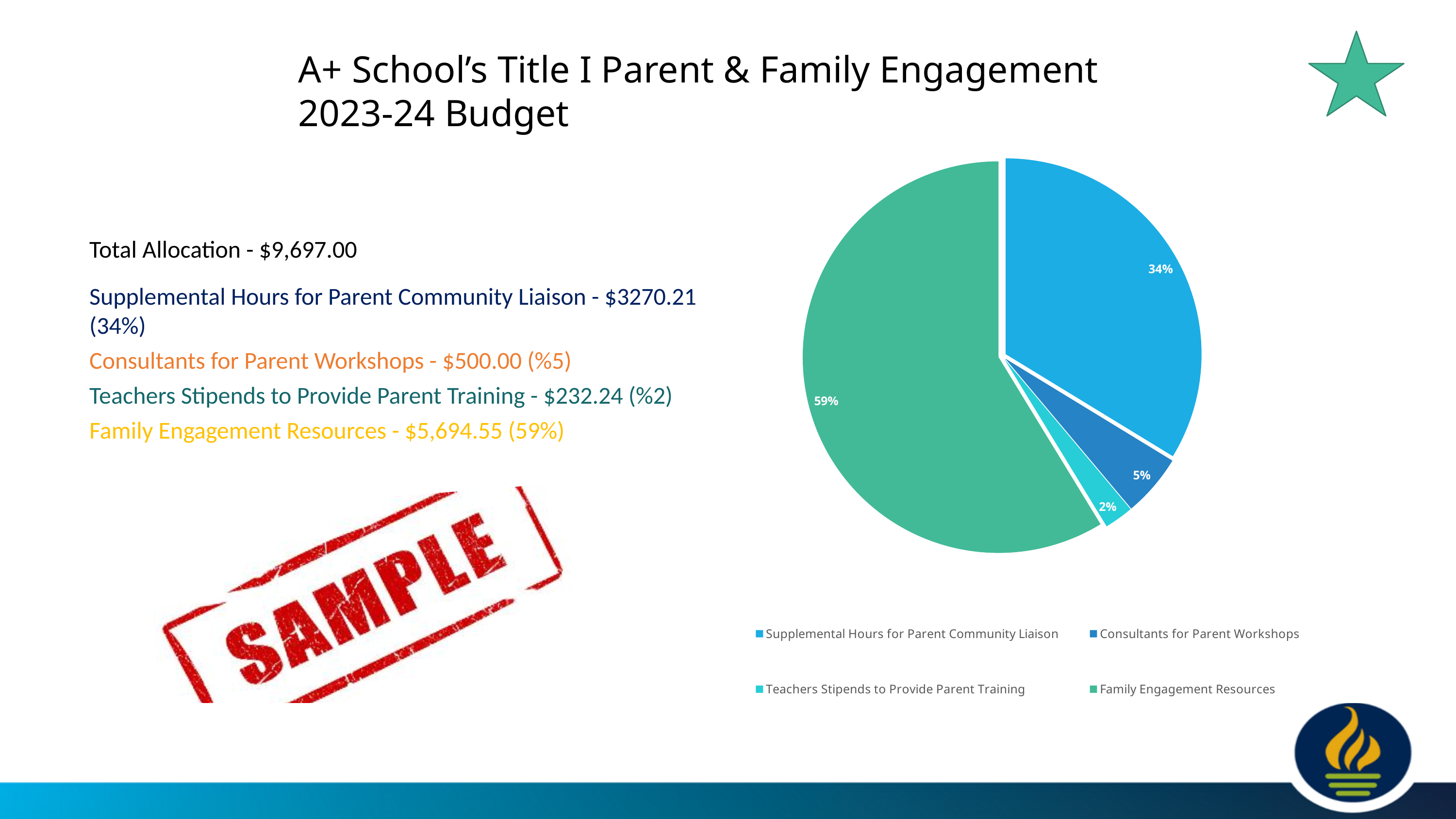
What share of the pie chart is Teachers Stipends to Provide Parent Training? 2% How many categories are shown in the pie chart? 4 What type of chart is shown on the slide? Pie chart Which category has the smallest slice of the pie chart? Teachers Stipends to Provide Parent Training What share of the pie chart is Family Engagement Resources? 59% What share of the pie chart is Supplemental Hours for Parent Community Liaison? 34% Which category has the largest slice of the pie chart? Family Engagement Resources Which slice is larger: Consultants for Parent Workshops or Teachers Stipends to Provide Parent Training? Consultants for Parent Workshops What colour is the Family Engagement Resources slice in the pie chart? Green By how many percentage points does the Family Engagement Resources slice exceed the Supplemental Hours for Parent Community Liaison slice? 25 percentage points How many entries does the chart legend list? 4